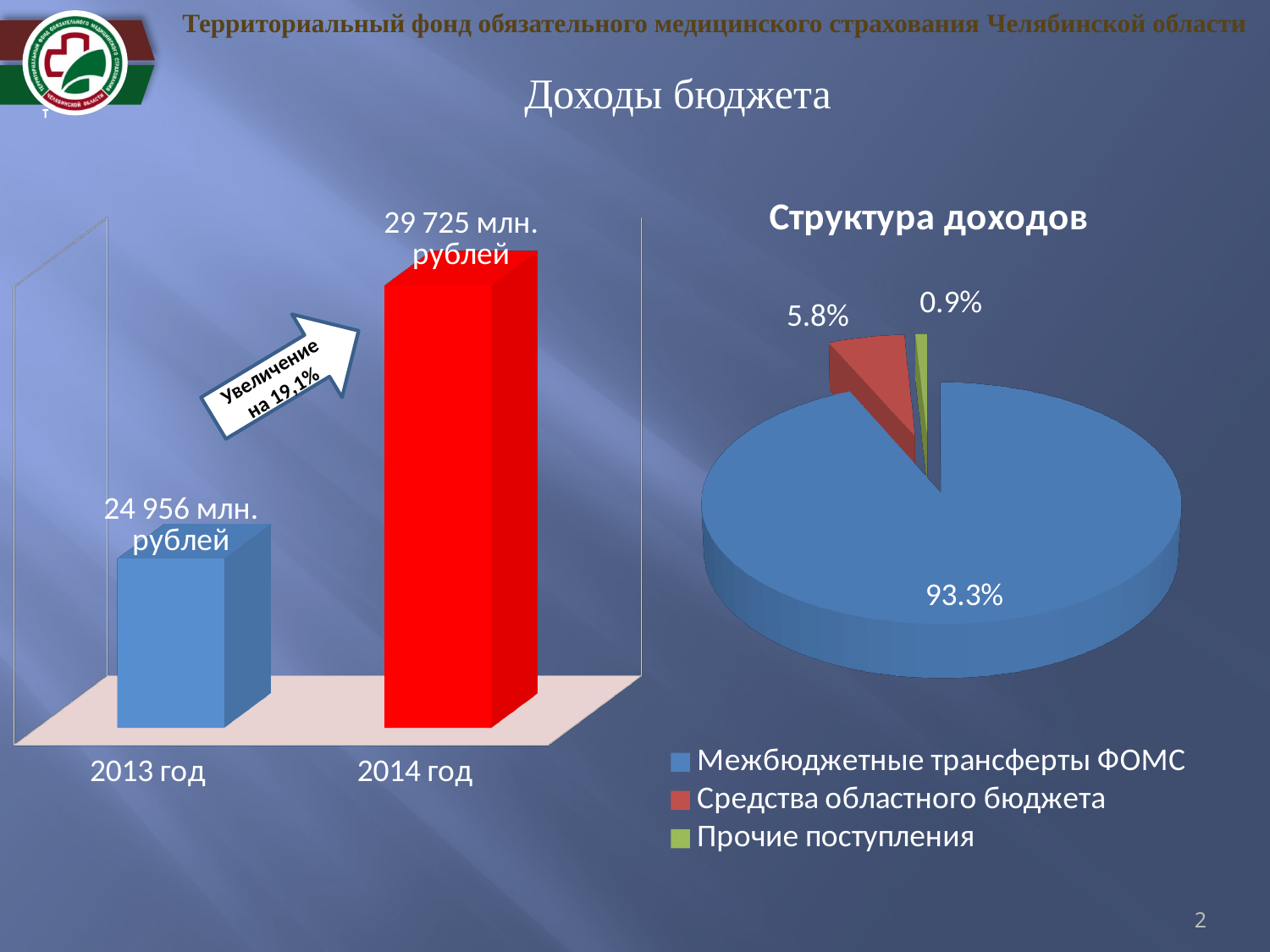
On the left bar chart, by how much does the 2014 год value exceed the 2013 год value? 4 769 млн. рублей In the 'Структура доходов' pie chart, what share is Средства областного бюджета? 5.8% What kind of chart is the left chart on the slide? Bar chart On the left bar chart, what is the value for 2013 год? 24 956 млн. рублей On the left bar chart, what is the value for 2014 год? 29 725 млн. рублей On the left bar chart, how many categories are shown? 2 On the left bar chart, do the values rise or fall from 2013 год to 2014 год? Rise How many entries does the legend of the 'Структура доходов' pie chart list? 3 In the 'Структура доходов' pie chart, what share is Межбюджетные трансферты ФОМС? 93.3% On the left bar chart, what percentage increase is indicated by the arrow? 19,1% On the left bar chart, which year has the higher value? 2014 год In the 'Структура доходов' pie chart, which category has the smallest share? Прочие поступления